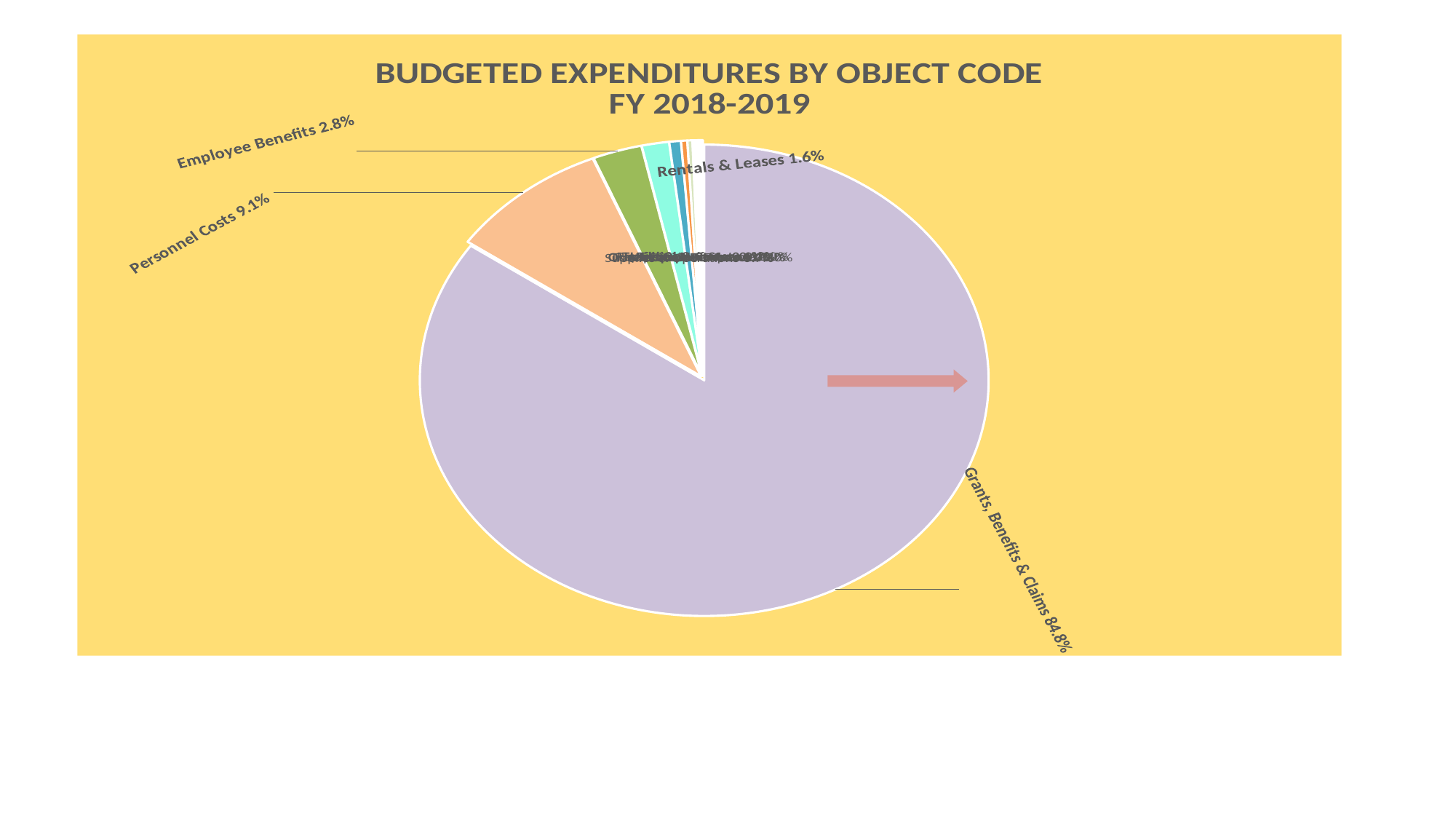
What fiscal year does the chart cover? FY 2018-2019 What percentage is shown for Personnel Costs? 9.1% What is the difference in percentage points between Personnel Costs and Employee Benefits? 6.3 Which is larger, Personnel Costs or Employee Benefits? Personnel Costs Which is larger, Employee Benefits or Rentals & Leases? Employee Benefits What percentage is shown for Employee Benefits? 2.8% What share of budgeted expenditures is Grants, Benefits & Claims? 84.8% What percentage is shown for Rentals & Leases? 1.6% Which object code has the largest share of budgeted expenditures? Grants, Benefits & Claims What is the title of the chart? BUDGETED EXPENDITURES BY OBJECT CODE FY 2018-2019 What type of chart is shown on the slide? pie chart What is the difference in percentage points between Grants, Benefits & Claims and Personnel Costs? 75.7